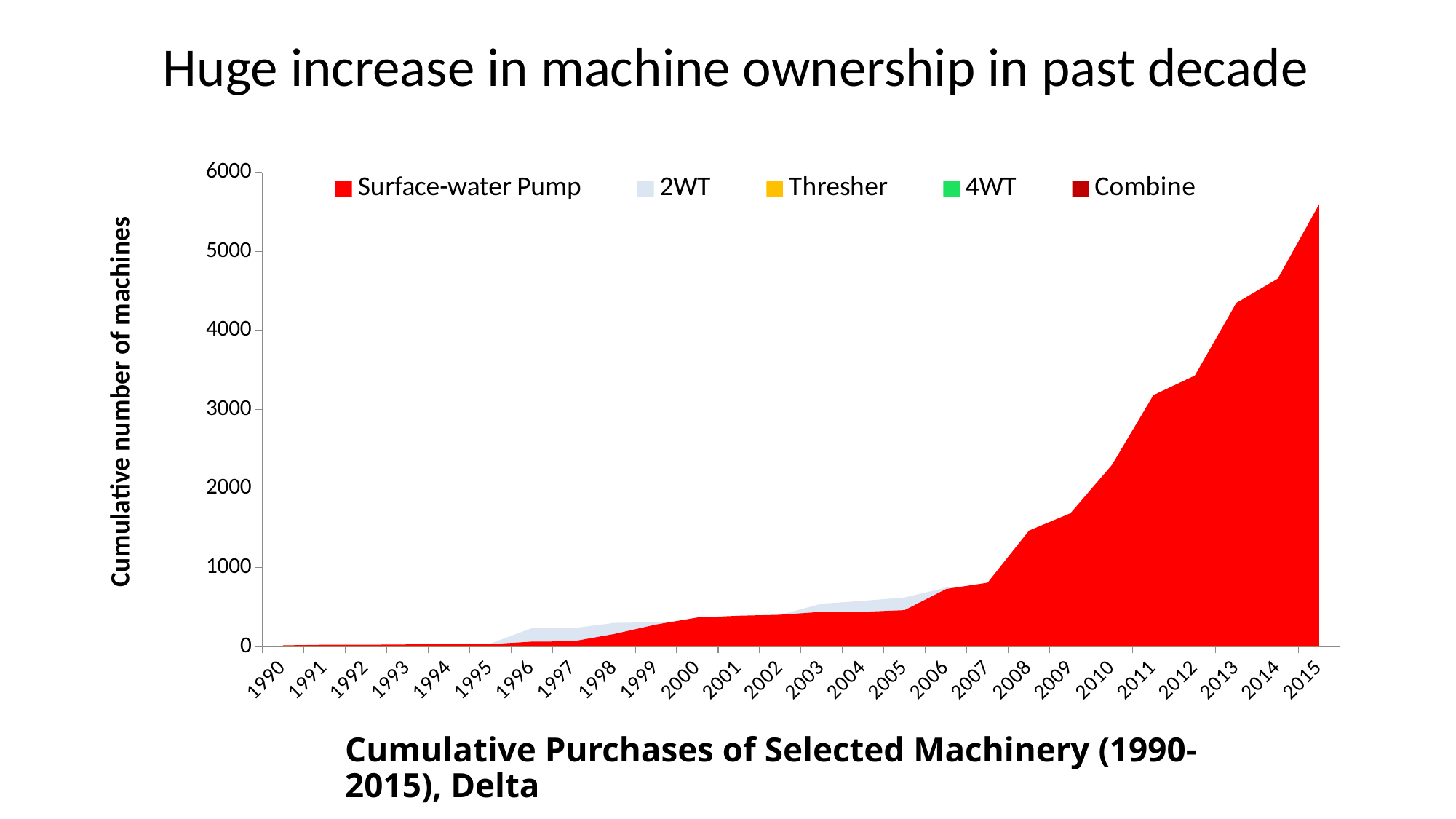
What is the label of the y axis? Cumulative number of machines Which is larger, the cumulative total in 2013 or in 2009? 2013 How many series does the legend list? 5 Is the value for Surface-water Pump in 2015 greater or less than 5000? greater Do the cumulative values rise or fall from 1990 to 2015? Rise Is the value for Surface-water Pump in 2005 greater or less than 1000? less In which year is the cumulative number of machines highest? 2015 How many years are plotted along the x axis? 26 What is the title printed below the chart? Cumulative Purchases of Selected Machinery (1990-2015), Delta Is the value for Surface-water Pump in 2010 greater or less than 2000? greater What kind of chart is shown on the slide? Area chart